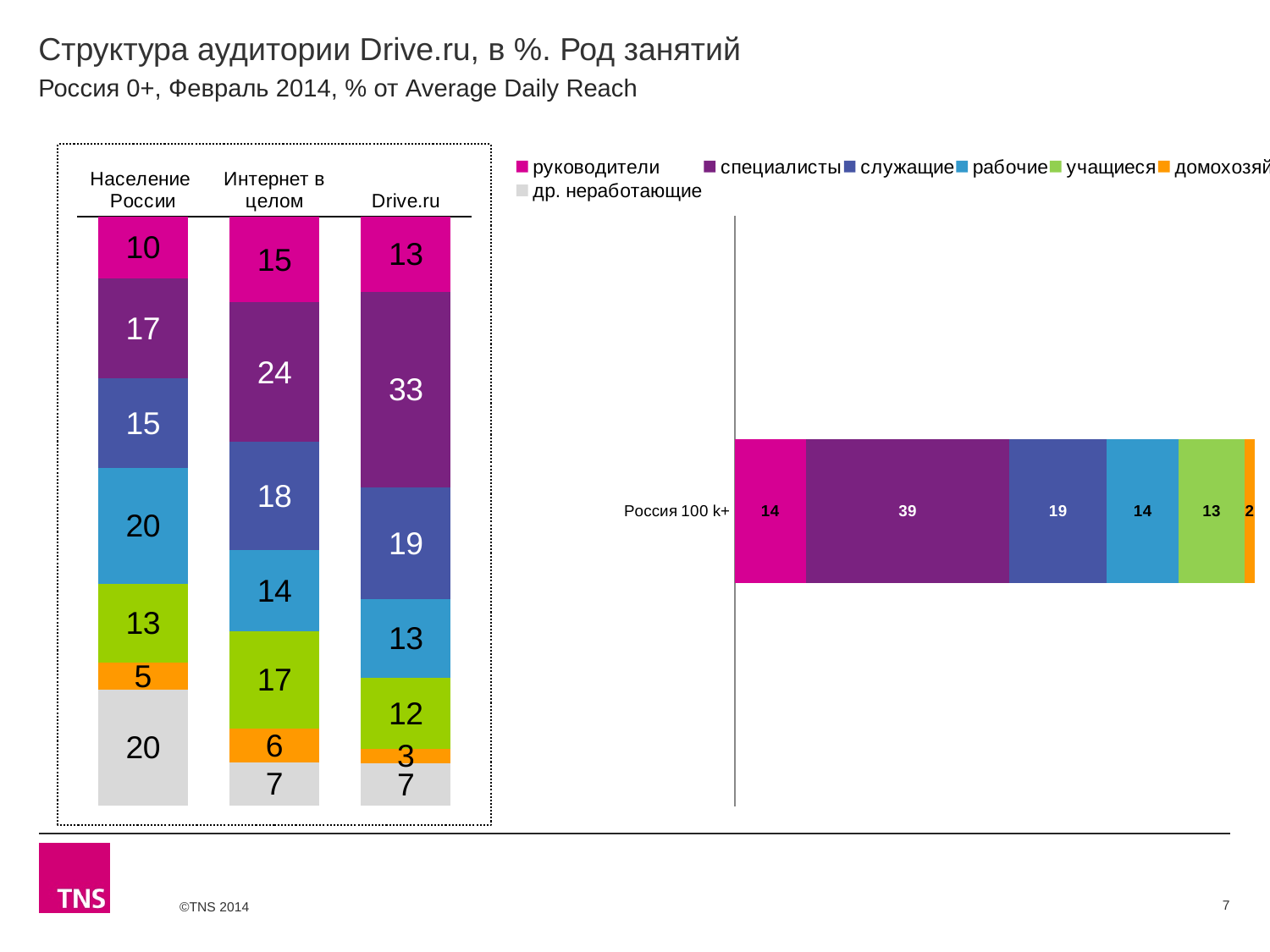
On the left chart, what is the value for специалисты in the Drive.ru column? 33 On the left chart, which is larger: руководители for Интернет в целом or руководители for Drive.ru? Интернет в целом On the left chart, what is the value for рабочие in the Население России column? 20 On the left chart, what is the difference between the специалисты values for Drive.ru and Население России? 16 How many columns (categories) does the left chart show? 3 On the left chart, which segment is the smallest in the Drive.ru column? домохозяйки How many series does the legend list? 7 What type of chart is the left chart? Stacked bar chart On the left chart, what is the value for учащиеся in the Интернет в целом column? 17 On the right chart (Россия 100 k+), what is the value for служащие? 19 On the right chart (Россия 100 k+), what is the value for специалисты? 39 On the left chart, which segment is the largest in the Drive.ru column? специалисты